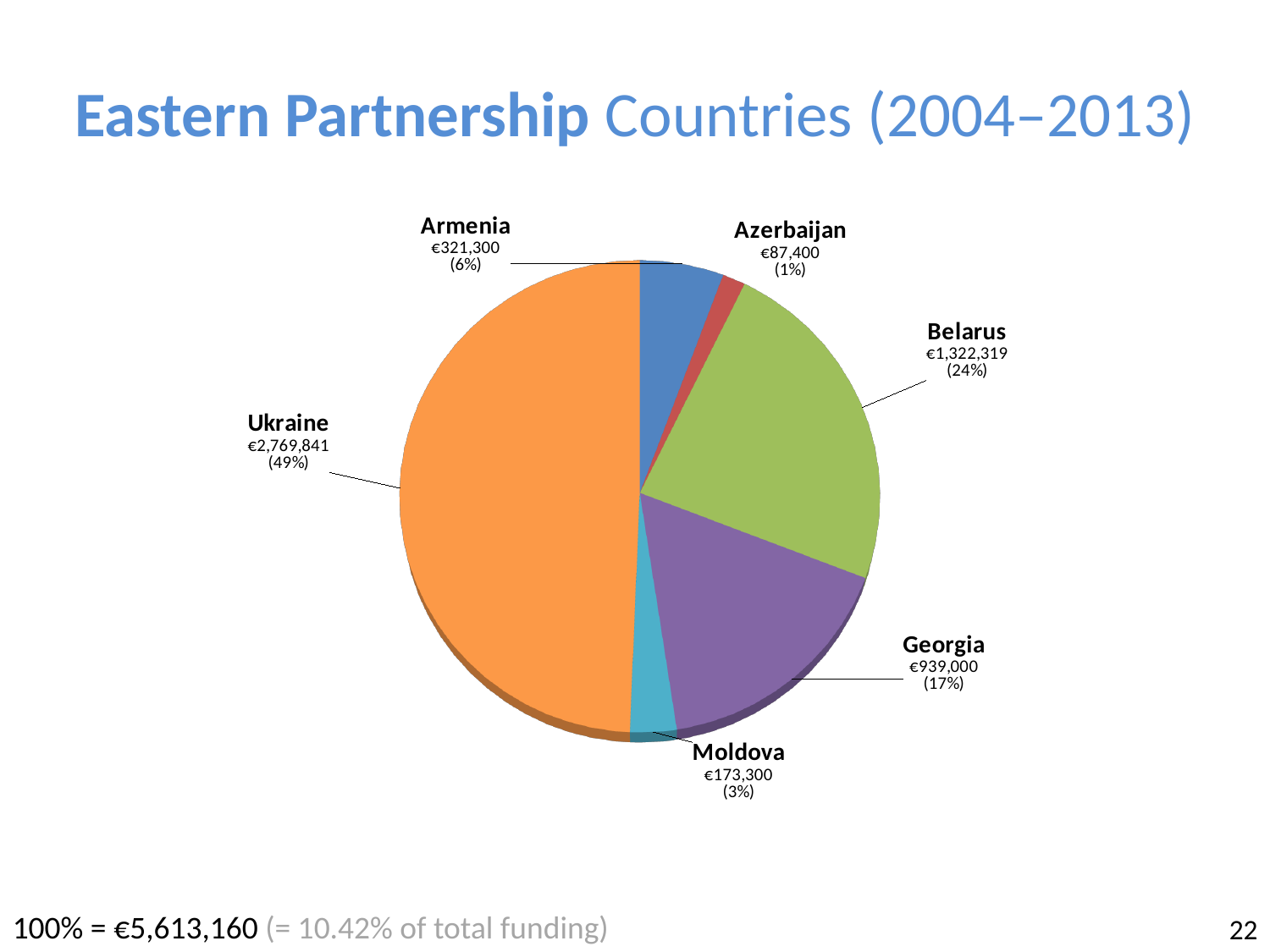
Which received more funding, Armenia or Moldova? Armenia Which country has the smallest share of the pie? Azerbaijan What total amount does 100% of the pie represent? €5,613,160 What is the funding value for Georgia? €939,000 Which country has the largest share of the pie? Ukraine What is the funding value for Belarus? €1,322,319 What is the funding value for Azerbaijan? €87,400 What percentage share does Ukraine have? 49% How many countries are shown in the pie chart? 6 What percentage share does Moldova have? 3% What type of chart is shown on the slide? pie chart What is the difference in funding between Belarus and Georgia? €383,319